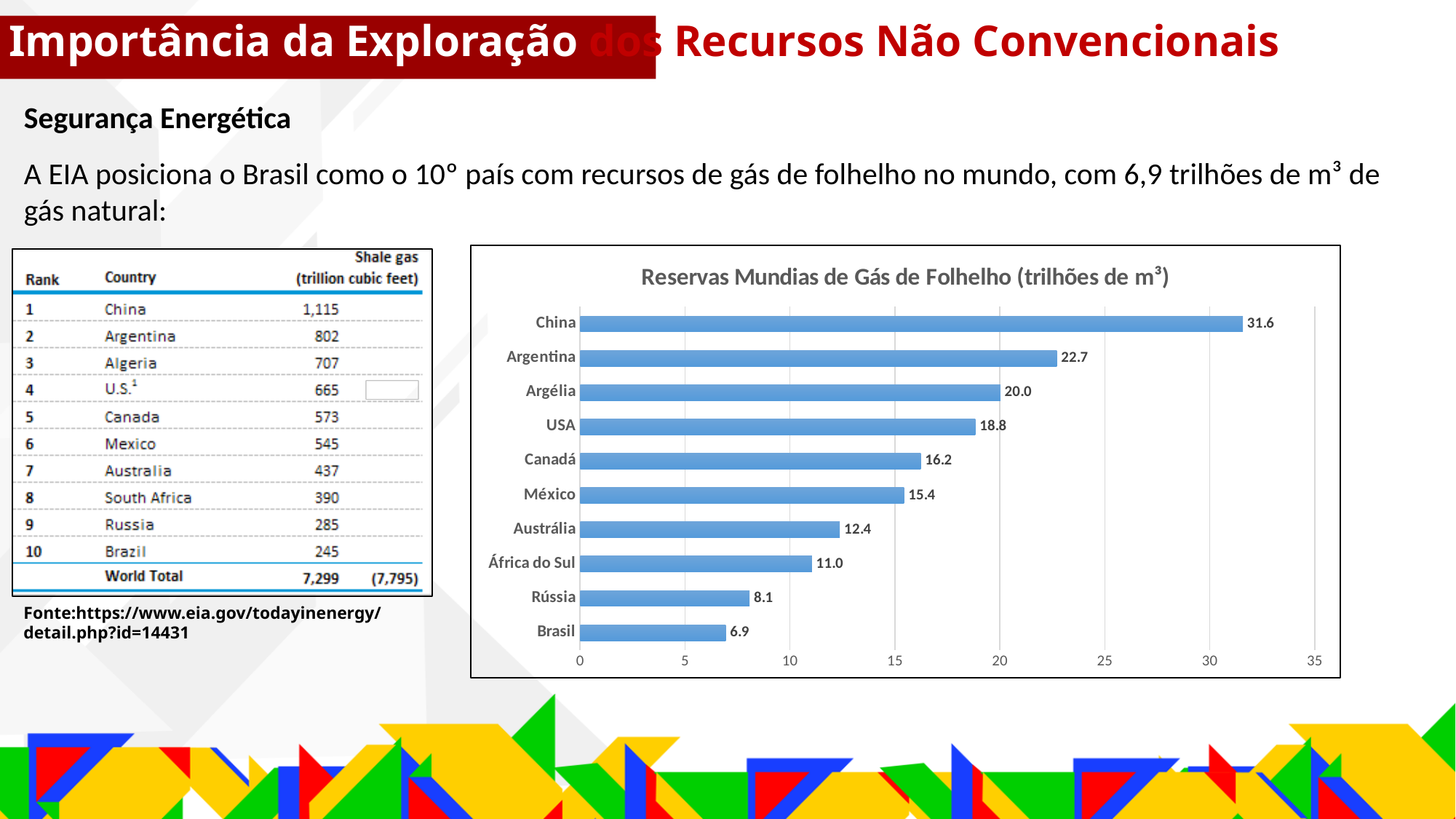
What is the difference between the values for China and Argentina? 8.9 What is the difference between the values for Rússia and Brasil? 1.2 What is the value for Brasil in the chart? 6.9 Which is larger, the value for Argélia or the value for USA? Argélia What kind of chart is shown on the slide? bar chart Which country has the lowest value in the chart? Brasil Which country has the highest value in the chart? China How many countries are shown in the chart? 10 What is the value for China in the chart? 31.6 What is the value for Canadá in the chart? 16.2 Is the value for México greater or less than 20? less What is the title of the chart? Reservas Mundias de Gás de Folhelho (trilhões de m³)